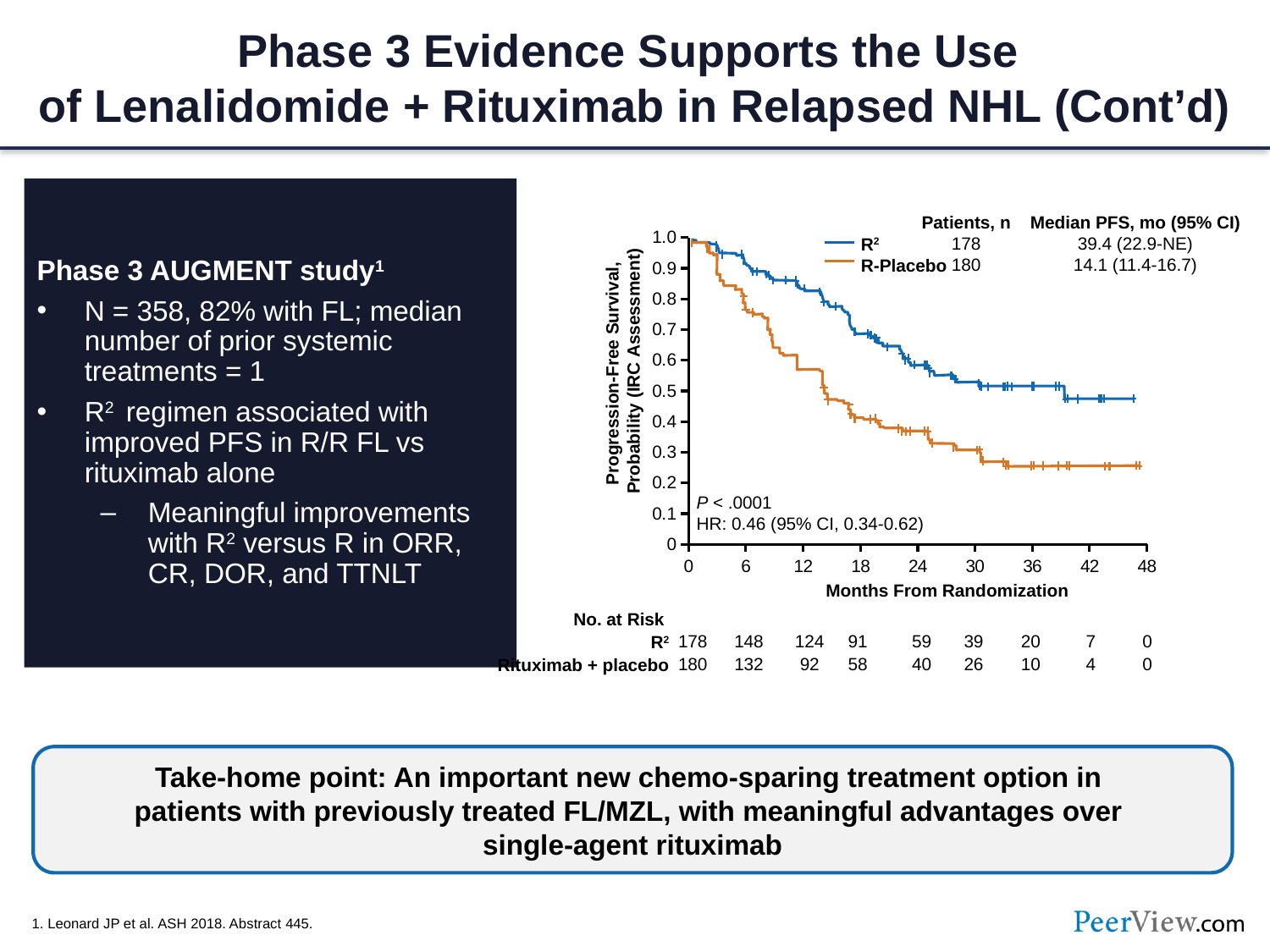
Is the progression-free survival probability for R-Placebo at 36 months greater or less than 0.3? less How many patients were in the R-Placebo arm? 180 What is the median PFS (95% CI) for the R-Placebo arm? 14.1 (11.4-16.7) What is the median PFS (95% CI) for the R² arm? 39.4 (22.9-NE) At 6 months, how many more patients were at risk in the R² arm than in the Rituximab + placebo arm? 16 Which curve is higher at 24 months, R² or R-Placebo? R² In the No. at Risk table, how many Rituximab + placebo patients were at risk at 24 months? 40 What kind of chart is shown on the slide? line chart What hazard ratio is printed on the chart? 0.46 What is the label of the x axis? Months From Randomization In the No. at Risk table, how many R² patients were at risk at 12 months? 124 How many series does the chart's legend list? 2